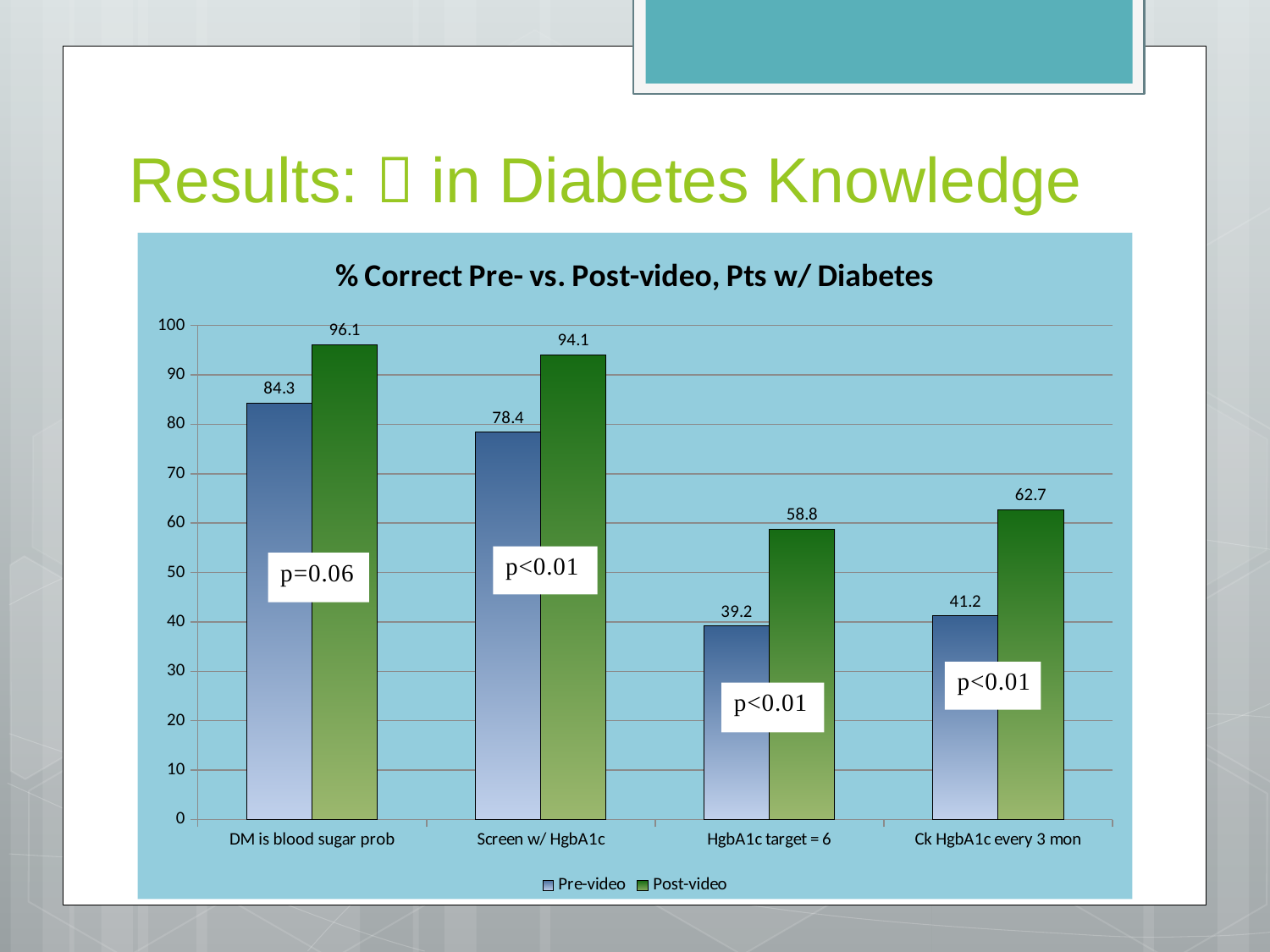
Which category has the highest Post-video value? DM is blood sugar prob What is the Pre-video value for "Ck HgbA1c every 3 mon"? 41.2 What is the Pre-video value for "DM is blood sugar prob"? 84.3 How many categories are shown on the x axis? 4 What is the Post-video value for "HgbA1c target = 6"? 58.8 How many series does the legend list? 2 Is the Pre-video value for "Screen w/ HgbA1c" greater or less than 70? greater What is the title of the chart? % Correct Pre- vs. Post-video, Pts w/ Diabetes What kind of chart is shown on the slide? bar chart Which is larger: the Post-video value for "HgbA1c target = 6" or the Post-video value for "Ck HgbA1c every 3 mon"? Ck HgbA1c every 3 mon Which category has the lowest Pre-video value? HgbA1c target = 6 What is the difference between the Post-video and Pre-video values for "Screen w/ HgbA1c"? 15.7